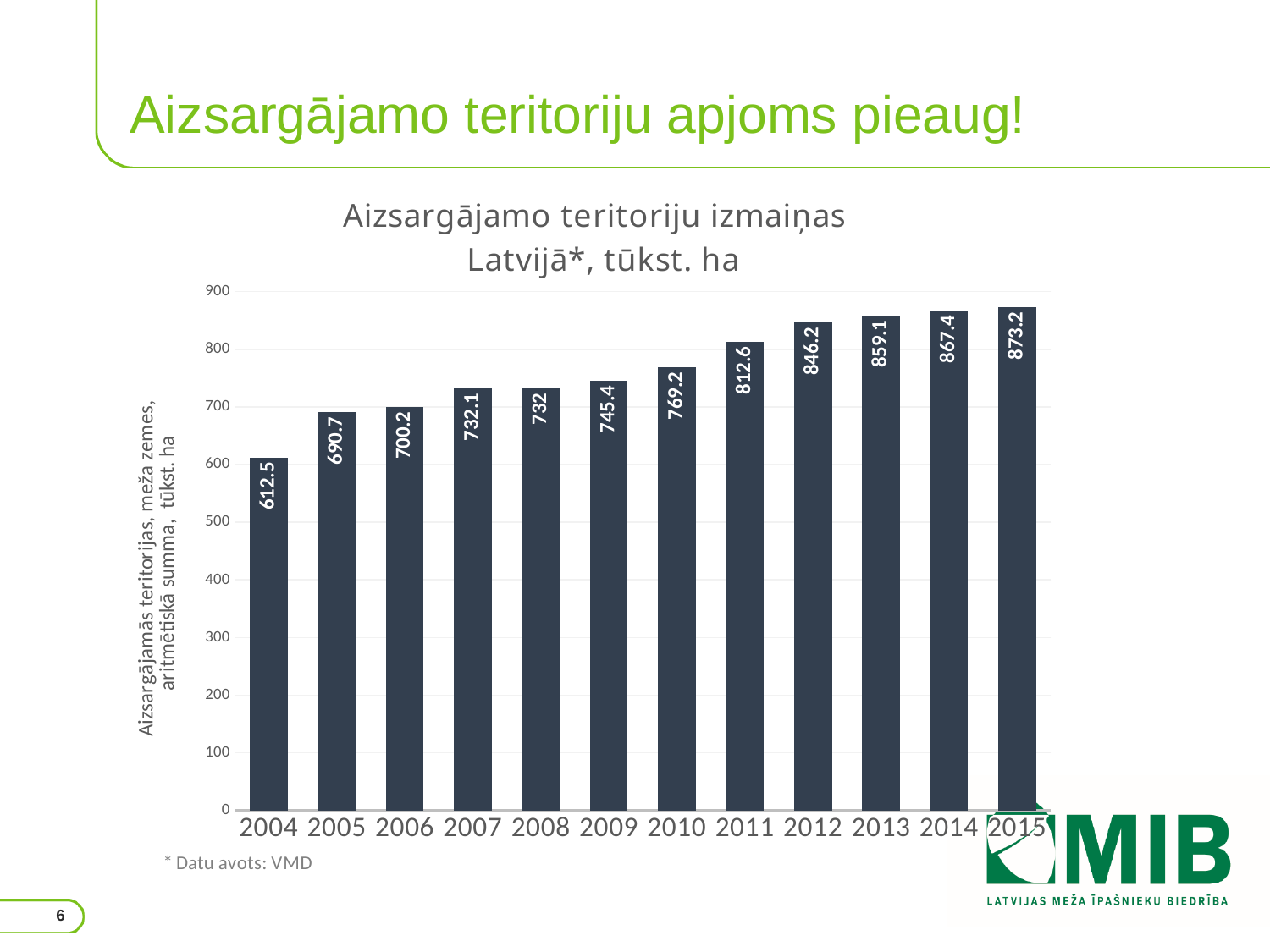
Which year has the lowest value? 2004 What kind of chart is this? bar chart Which is larger, the value for 2009 or the value for 2010? 2010 Is the value for 2012 greater or less than 800? greater How many years are shown on the x axis? 12 Which year has the highest value? 2015 What is the value for 2004? 612.5 What is the value for 2015? 873.2 What is the difference between the values for 2015 and 2004? 260.7 What is the title of the chart? Aizsargājamo teritoriju izmaiņas Latvijā*, tūkst. ha Do the values generally rise or fall from 2004 to 2015? rise What is the value for 2011? 812.6